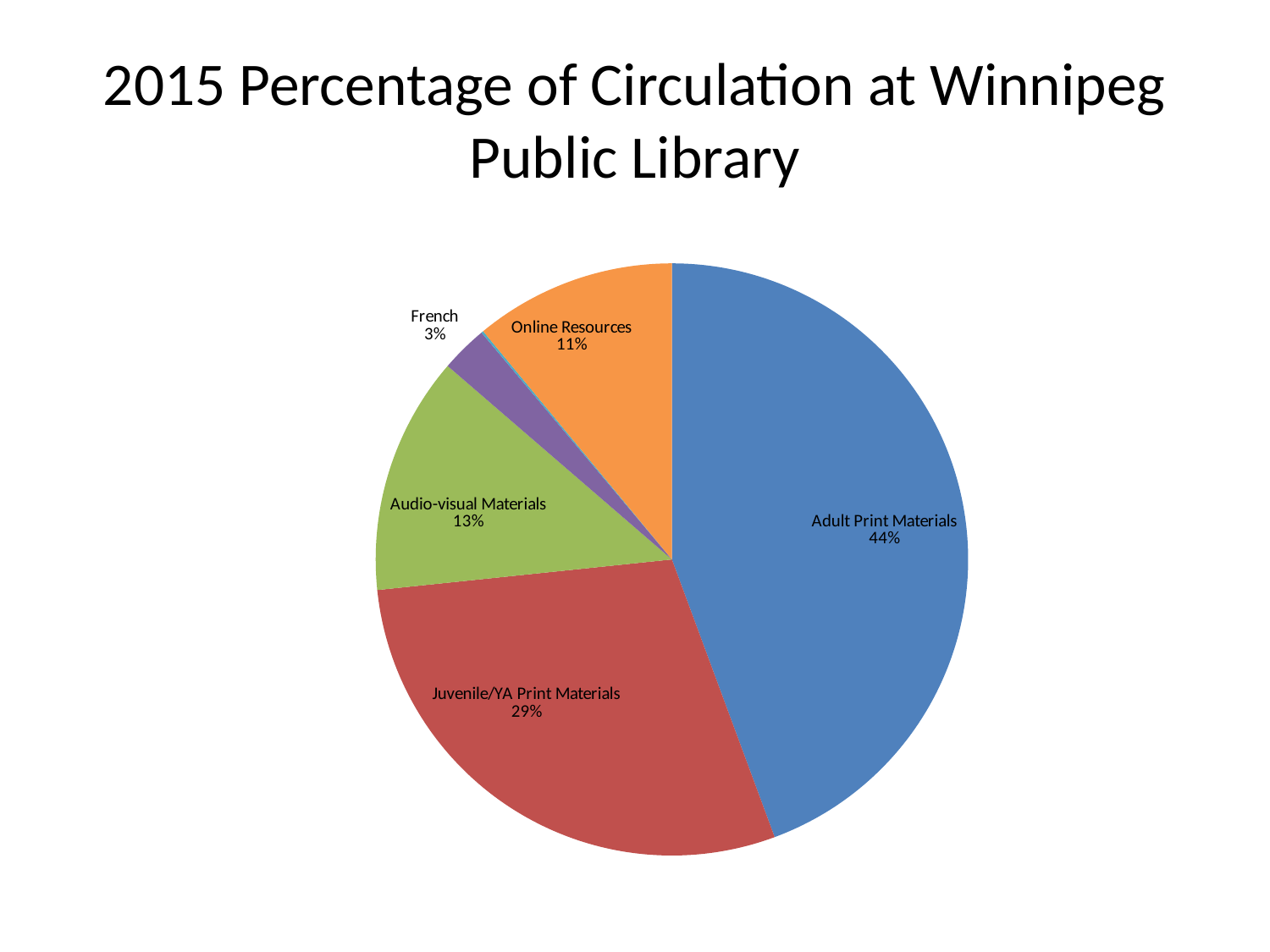
What percentage of circulation is Online Resources? 11% What percentage of circulation is Juvenile/YA Print Materials? 29% Which is larger, the share for Audio-visual Materials or the share for Online Resources? Audio-visual Materials What is the title of the chart? 2015 Percentage of Circulation at Winnipeg Public Library What kind of chart is shown on the slide? pie chart Which category has the largest share of circulation? Adult Print Materials What percentage of circulation is French? 3% What is the difference in percentage points between Adult Print Materials and Juvenile/YA Print Materials? 15 What percentage of circulation is Audio-visual Materials? 13% What percentage of circulation is Adult Print Materials? 44%